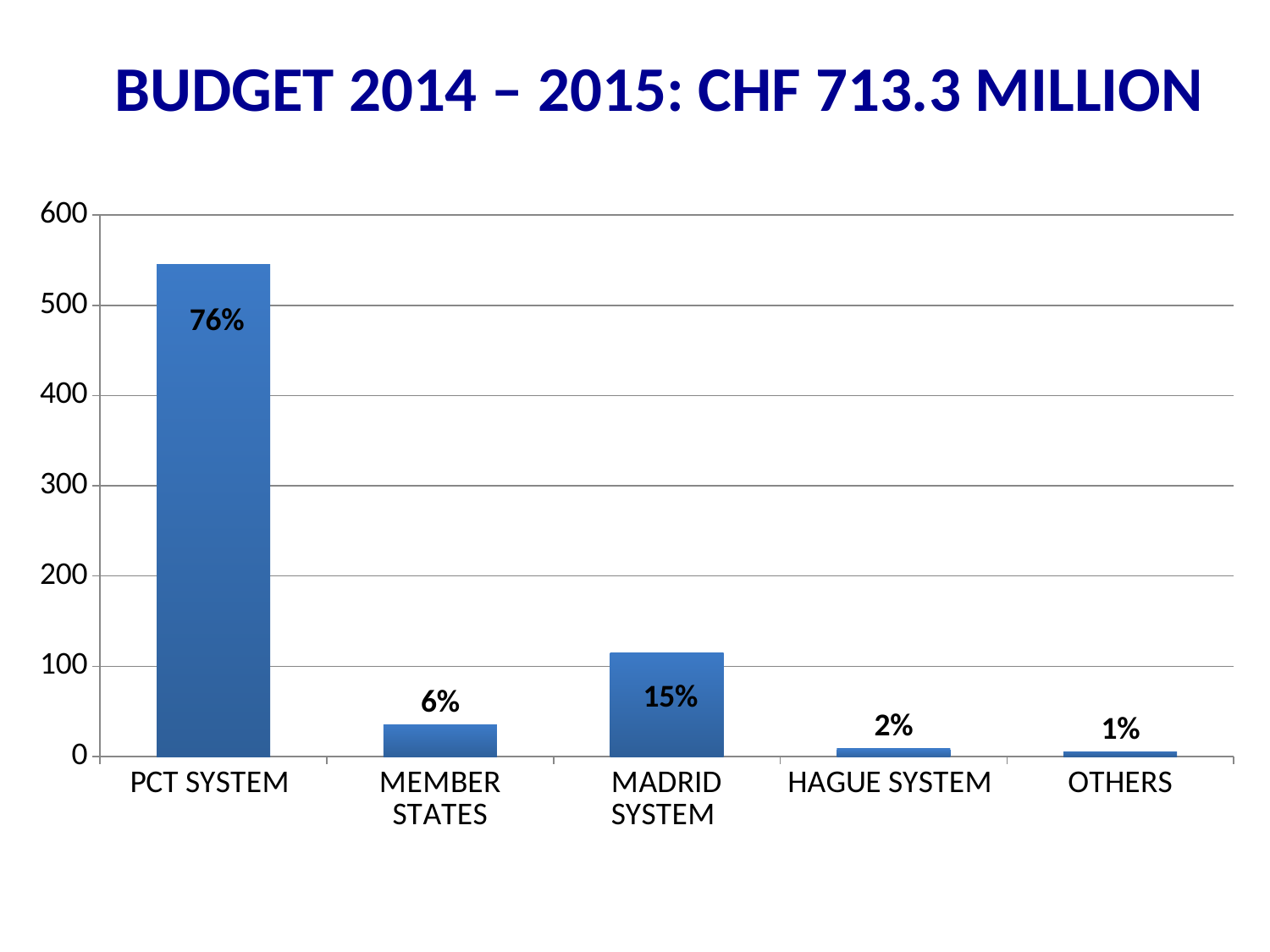
Is the value for MEMBER STATES greater or less than 100? less What percentage label is shown on the PCT SYSTEM bar? 76% By how many percentage points does the PCT SYSTEM label exceed the MADRID SYSTEM label? 61 percentage points Which category has the highest bar? PCT SYSTEM What percentage label is shown on the MADRID SYSTEM bar? 15% Which category has the lowest bar? OTHERS How many categories are shown on the x axis? 5 What percentage label is shown on the HAGUE SYSTEM bar? 2% Is the value for PCT SYSTEM greater or less than 500? greater What is the title of the slide? BUDGET 2014 – 2015: CHF 713.3 MILLION Which is larger, the bar for MEMBER STATES or the bar for MADRID SYSTEM? MADRID SYSTEM What percentage label is shown on the MEMBER STATES bar? 6%